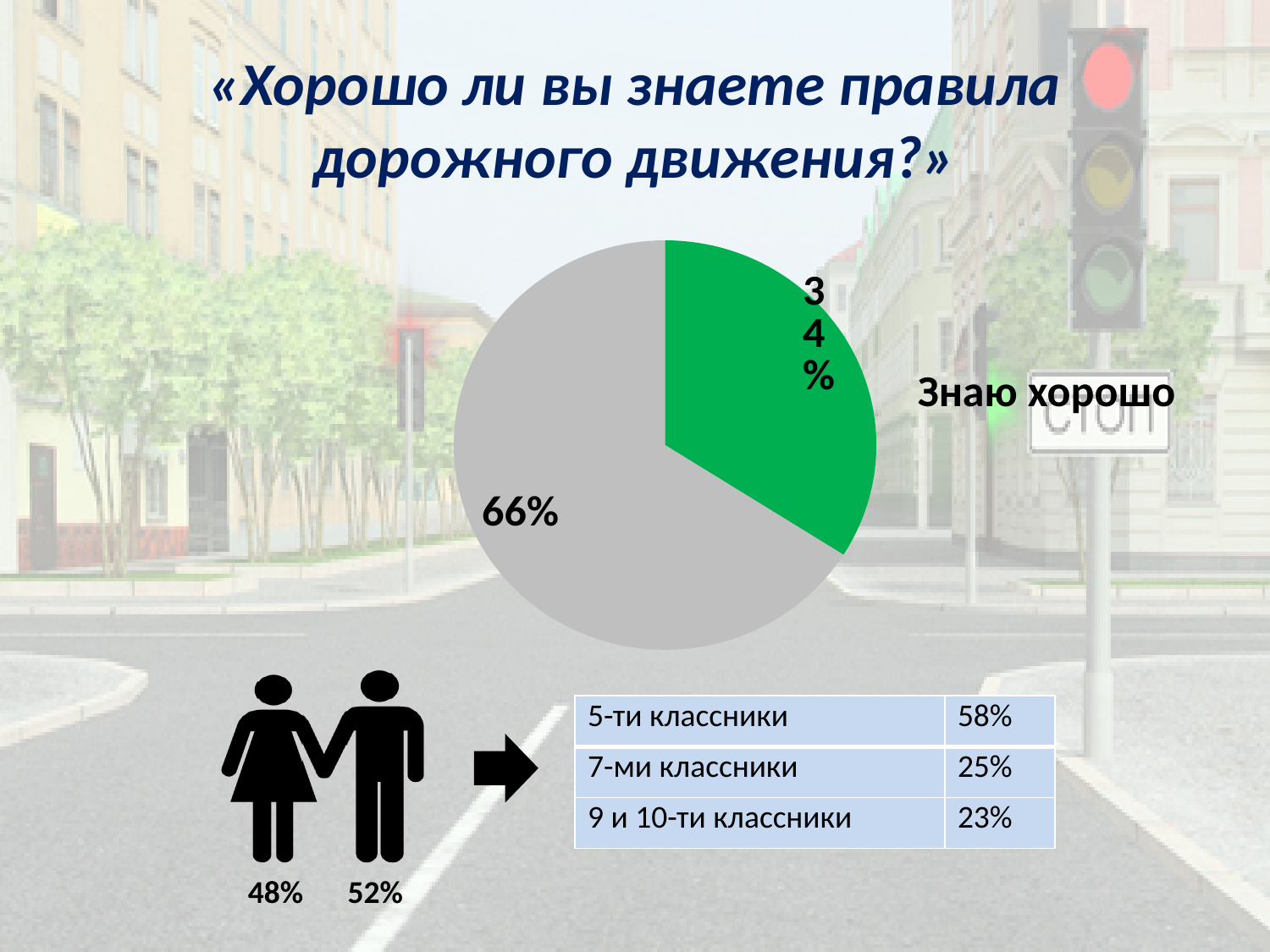
What is the title of the slide containing the pie chart? «Хорошо ли вы знаете правила дорожного движения?» What is the difference in percentage points between the grey slice and the green "Знаю хорошо" slice of the pie chart? 32 What is the total of the two slices shown in the pie chart? 100% What percentage is shown on the grey slice of the pie chart? 66% Which slice of the pie chart is larger, the green one or the grey one? the grey one How many slices does the pie chart have? 2 What colour is the slice labelled "Знаю хорошо" in the pie chart? green What percentage is shown for the green slice labelled "Знаю хорошо" in the pie chart? 34% What kind of chart is shown on the slide? pie chart Is the share of the "Знаю хорошо" slice in the pie chart greater or less than 50%? less